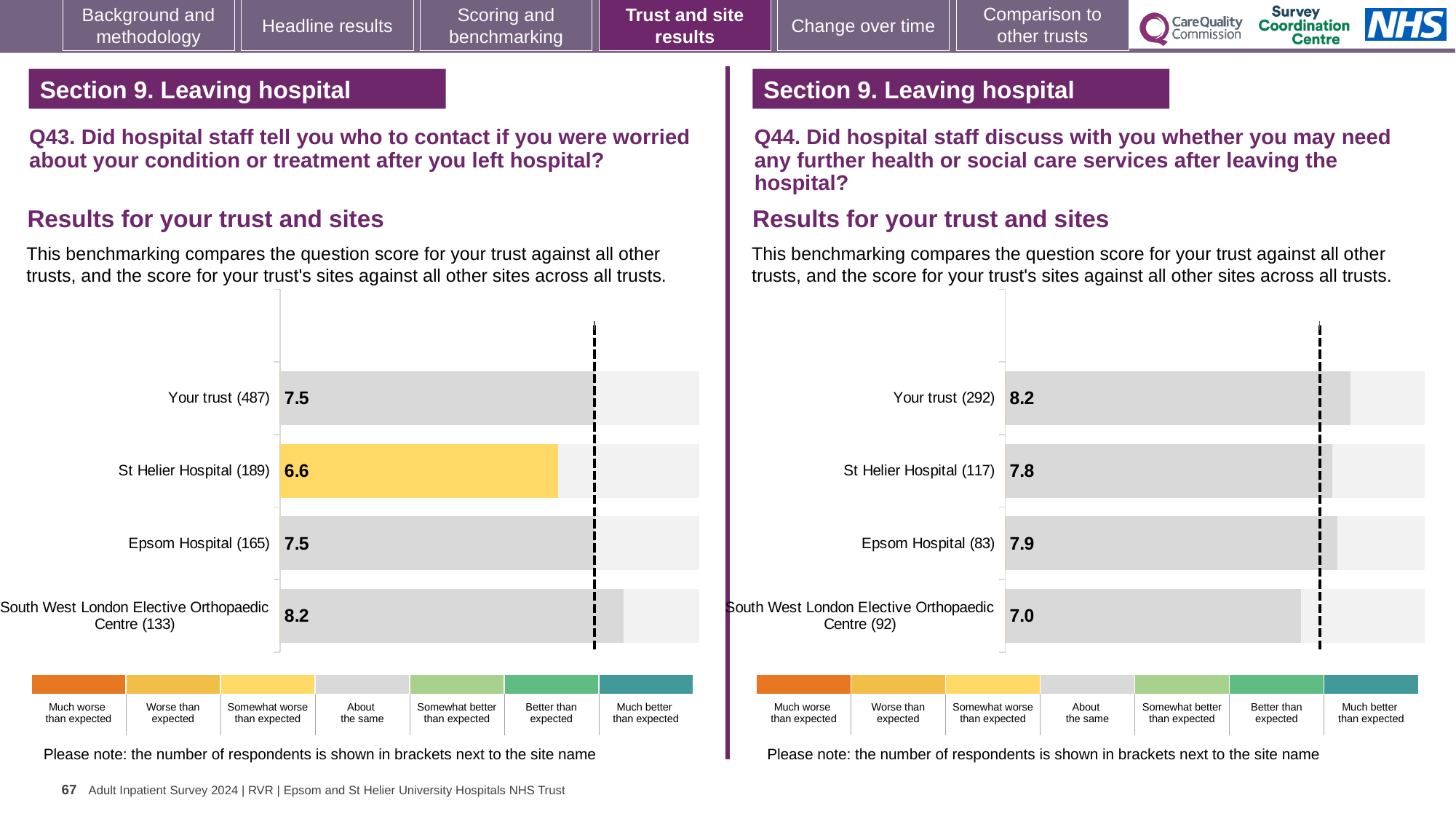
On the Q43 chart (left), how many bars are plotted? 4 On the Q44 chart (right), what is the difference between the scores for Your trust and South West London Elective Orthopaedic Centre? 1.2 On the Q43 chart (left), which site has the lowest score? St Helier Hospital On the Q44 chart (right), which site has the lowest score? South West London Elective Orthopaedic Centre On the Q43 chart (left), what is the score for St Helier Hospital? 6.6 What type of chart is used on the Q43 chart (left)? Bar chart On the Q43 chart (left), which site has the highest score? South West London Elective Orthopaedic Centre On the Q44 chart (right), which is larger: the score for St Helier Hospital or Epsom Hospital? Epsom Hospital On the Q43 chart (left), what is the score for South West London Elective Orthopaedic Centre? 8.2 On the Q43 chart (left), what is the difference between the scores for South West London Elective Orthopaedic Centre and St Helier Hospital? 1.6 On the Q44 chart (right), what is the score for Epsom Hospital? 7.9 On the Q44 chart (right), what is the score for Your trust? 8.2